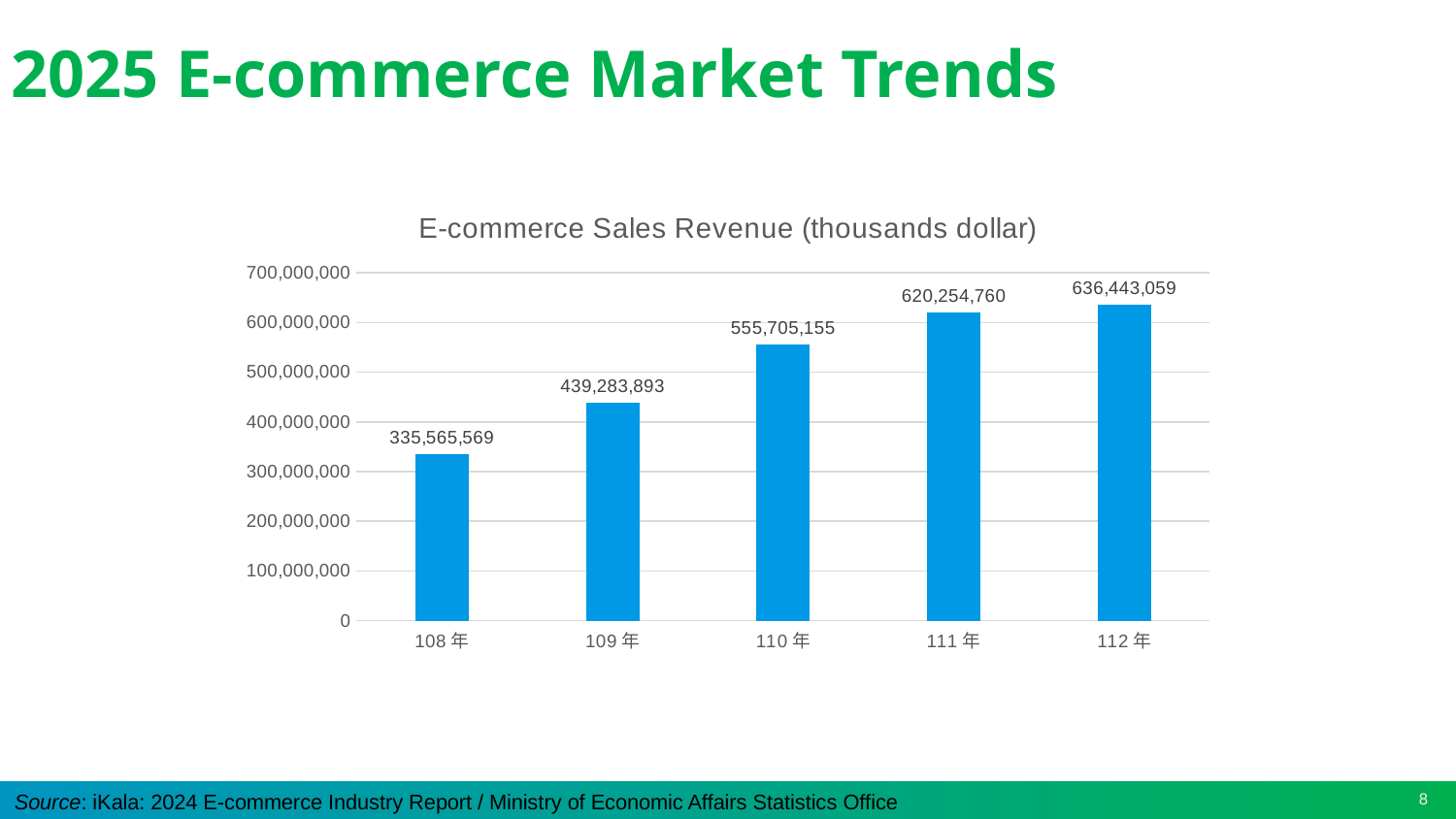
What is the e-commerce sales revenue for 110 年? 555,705,155 Which year has the highest e-commerce sales revenue? 112 年 Which has higher e-commerce sales revenue, 109 年 or 110 年? 110 年 What is the e-commerce sales revenue for 112 年? 636,443,059 What is the difference in e-commerce sales revenue between 112 年 and 111 年? 16,188,299 What is the e-commerce sales revenue for 108 年? 335,565,569 What is the difference in e-commerce sales revenue between 109 年 and 108 年? 103,718,324 Is the e-commerce sales revenue for 111 年 greater or less than 600,000,000? greater How many years are shown in the chart? 5 Which year has the lowest e-commerce sales revenue? 108 年 What kind of chart is shown on the slide? bar chart Does e-commerce sales revenue rise or fall from 108 年 to 112 年? rise